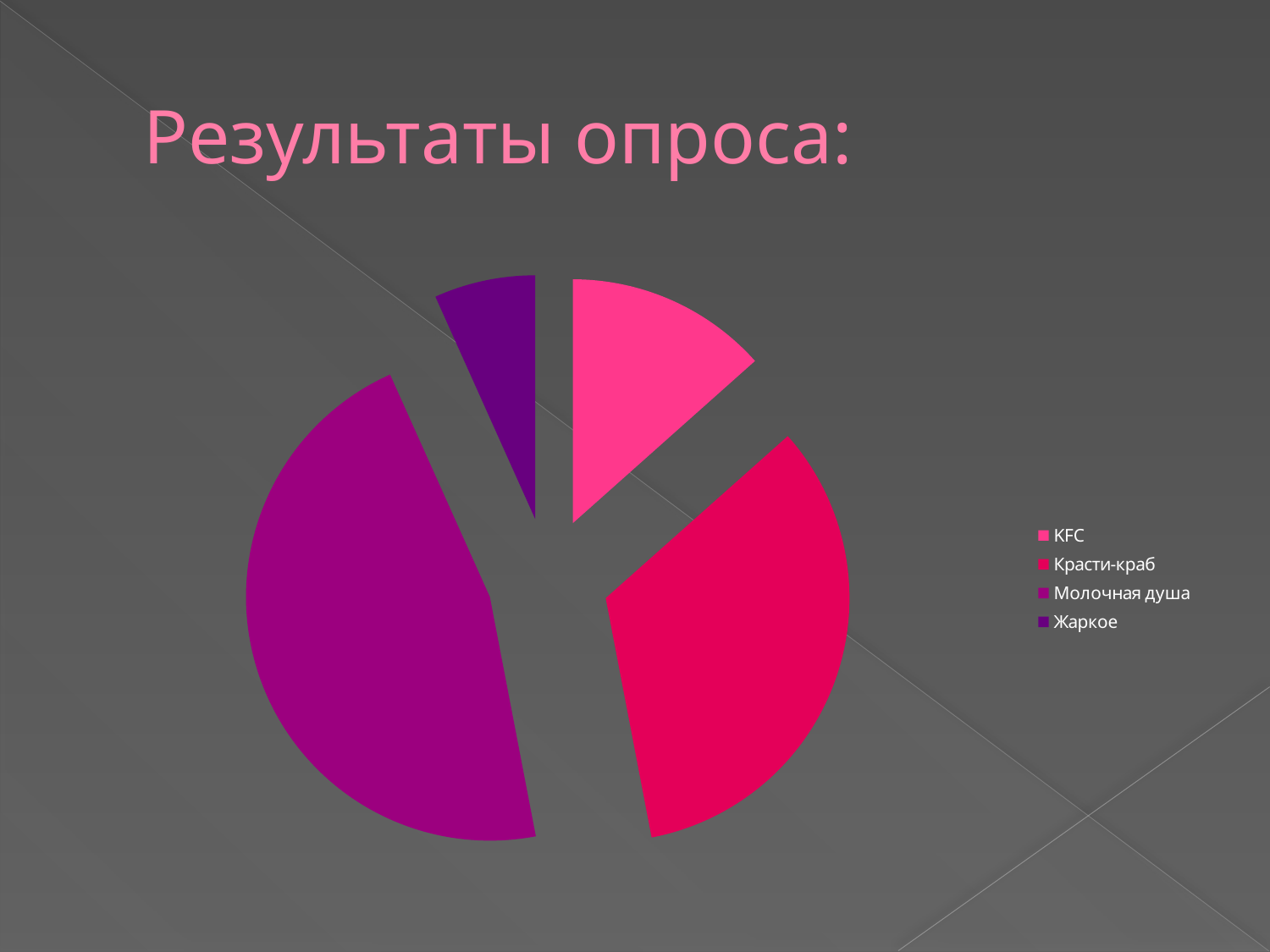
Which slice is larger, Красти-краб or KFC? Красти-краб Which category has the smallest slice in the pie chart? Жаркое How many entries does the legend of the pie chart list? 4 What is the title of the slide with the pie chart? Результаты опроса: Which category is shown in the darkest purple colour in the pie chart? Жаркое What kind of chart is shown on the slide? pie chart Which slice is larger, KFC or Жаркое? KFC How many slices does the pie chart have? 4 Which category has the largest slice in the pie chart? Молочная душа Which slice is larger, Молочная душа or Красти-краб? Молочная душа